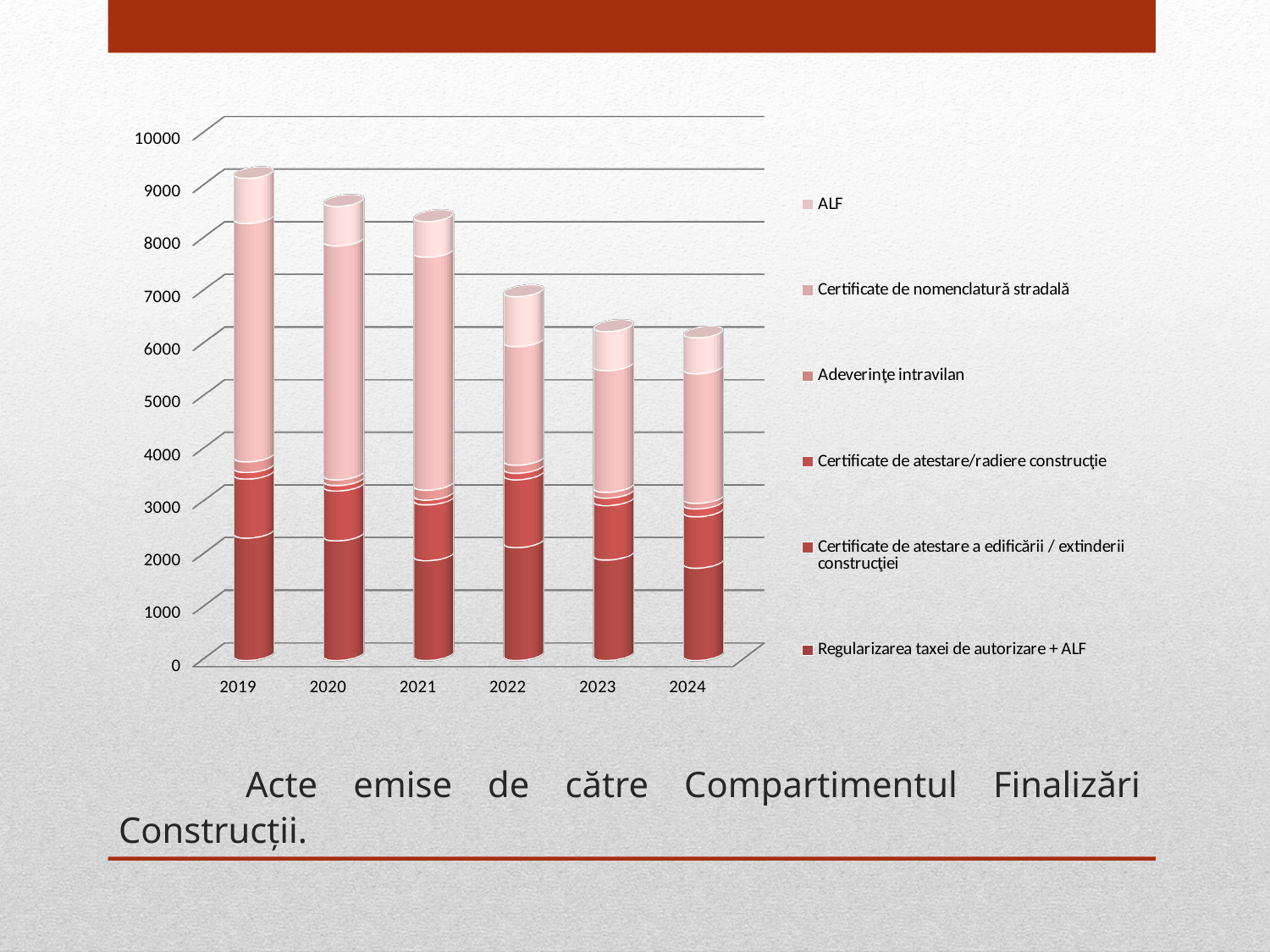
Is the total value for 2022 greater or less than 8000? less How many years are shown on the x axis of the chart? 6 What is the caption text below the chart? Acte emise de către Compartimentul Finalizări Construcții. Is the total value for 2023 greater or less than 5000? greater Which year has the larger total bar, 2019 or 2022? 2019 Which year has the highest total stacked bar? 2019 Is the total value for 2019 greater or less than 8000? greater How many series does the chart's legend list? 6 Do the total bar heights generally rise or fall from 2019 to 2024? fall What kind of chart is shown on the slide? bar chart Which legend entry is listed first (at the top) in the chart's legend? ALF